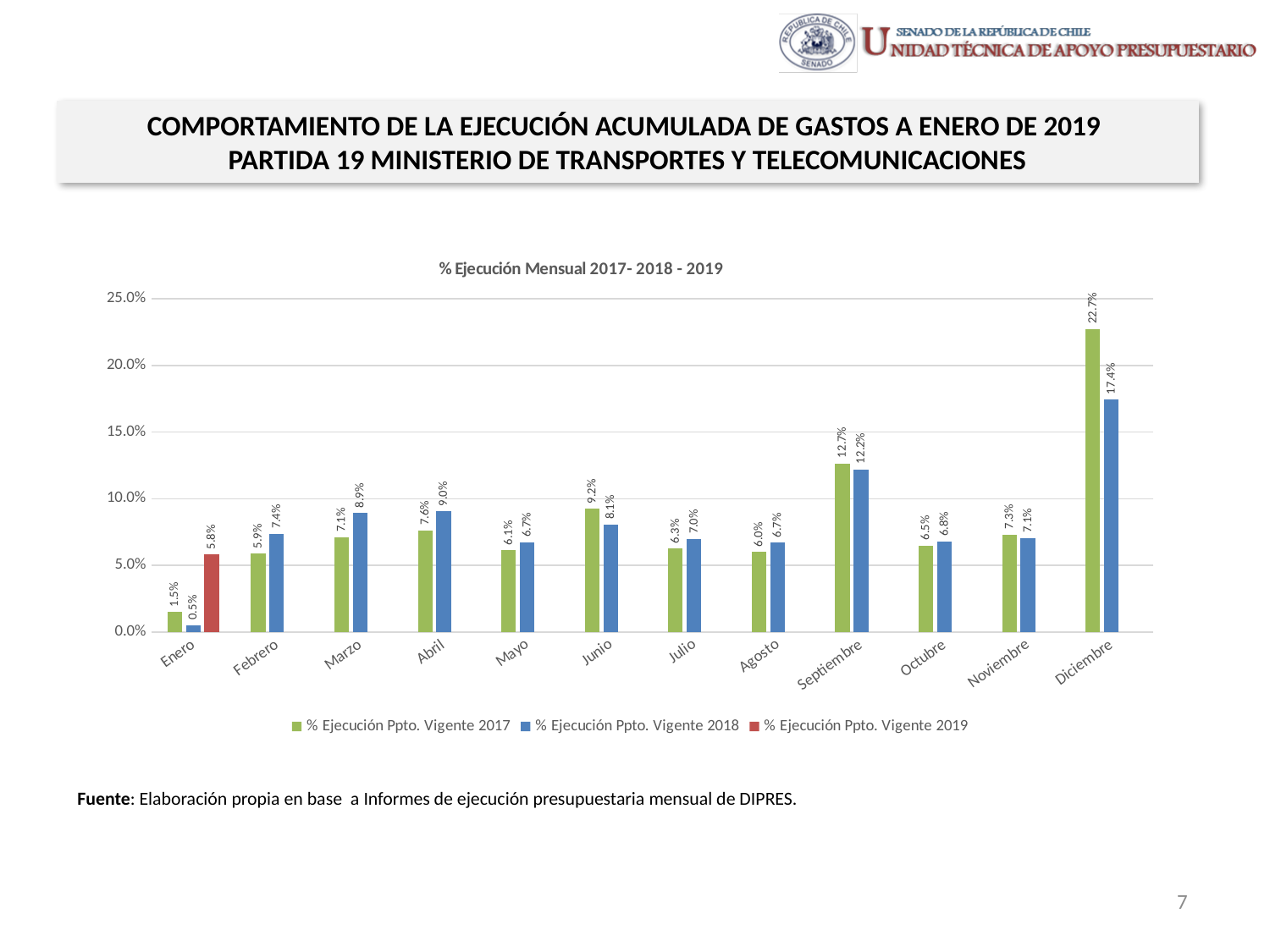
What is the value of % Ejecución Ppto. Vigente 2019 for Enero? 5.8% Which month has the lowest value for % Ejecución Ppto. Vigente 2018? Enero What is the value of % Ejecución Ppto. Vigente 2017 for Septiembre? 12.7% Which month has the highest value for % Ejecución Ppto. Vigente 2017? Diciembre What is the value of % Ejecución Ppto. Vigente 2018 for Diciembre? 17.4% What is the difference between the 2017 and 2018 values for Diciembre? 5.3% Which is larger for Junio: the 2017 value or the 2018 value? 2017 (9.2%) How many months are shown on the x axis? 12 What kind of chart is shown on the slide? Bar chart How many series does the legend list? 3 What is the title of the chart? % Ejecución Mensual 2017- 2018 - 2019 Is the value of % Ejecución Ppto. Vigente 2017 for Diciembre greater or less than 20.0%? greater